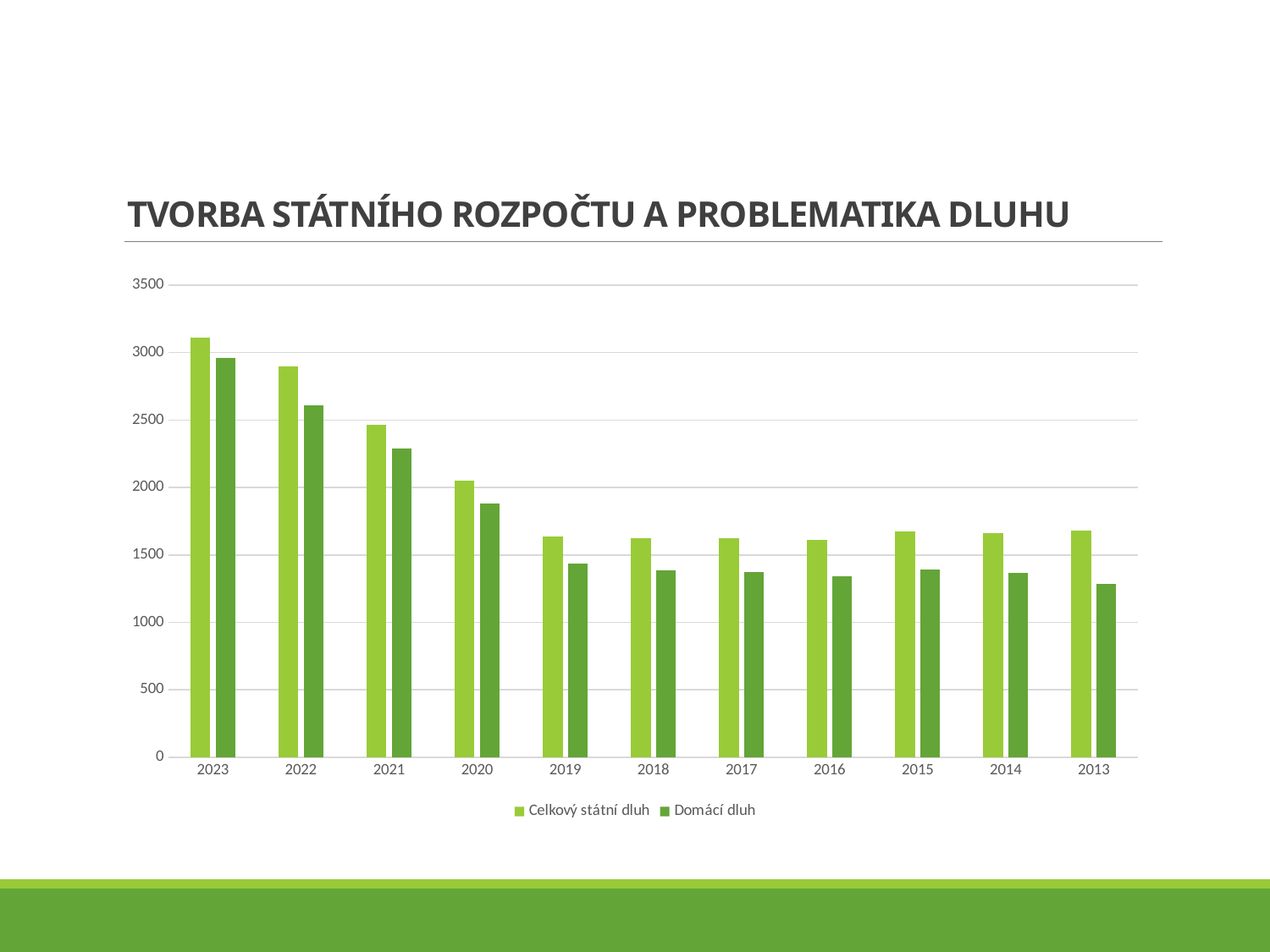
Is the value for Celkový státní dluh in 2023 greater or less than 3000? greater Which year has the highest value for Domácí dluh? 2023 How many years are shown on the x axis? 11 What kind of chart is shown on the slide? bar chart Which is larger in 2021: Celkový státní dluh or Domácí dluh? Celkový státní dluh Which year has the highest value for Celkový státní dluh? 2023 Is the value for Domácí dluh in 2019 greater or less than 1500? less Is the value for Domácí dluh in 2020 greater or less than 2000? less Do the values for Celkový státní dluh generally rise or fall moving from left (2023) to right (2013) along the x axis? fall How many series does the legend list? 2